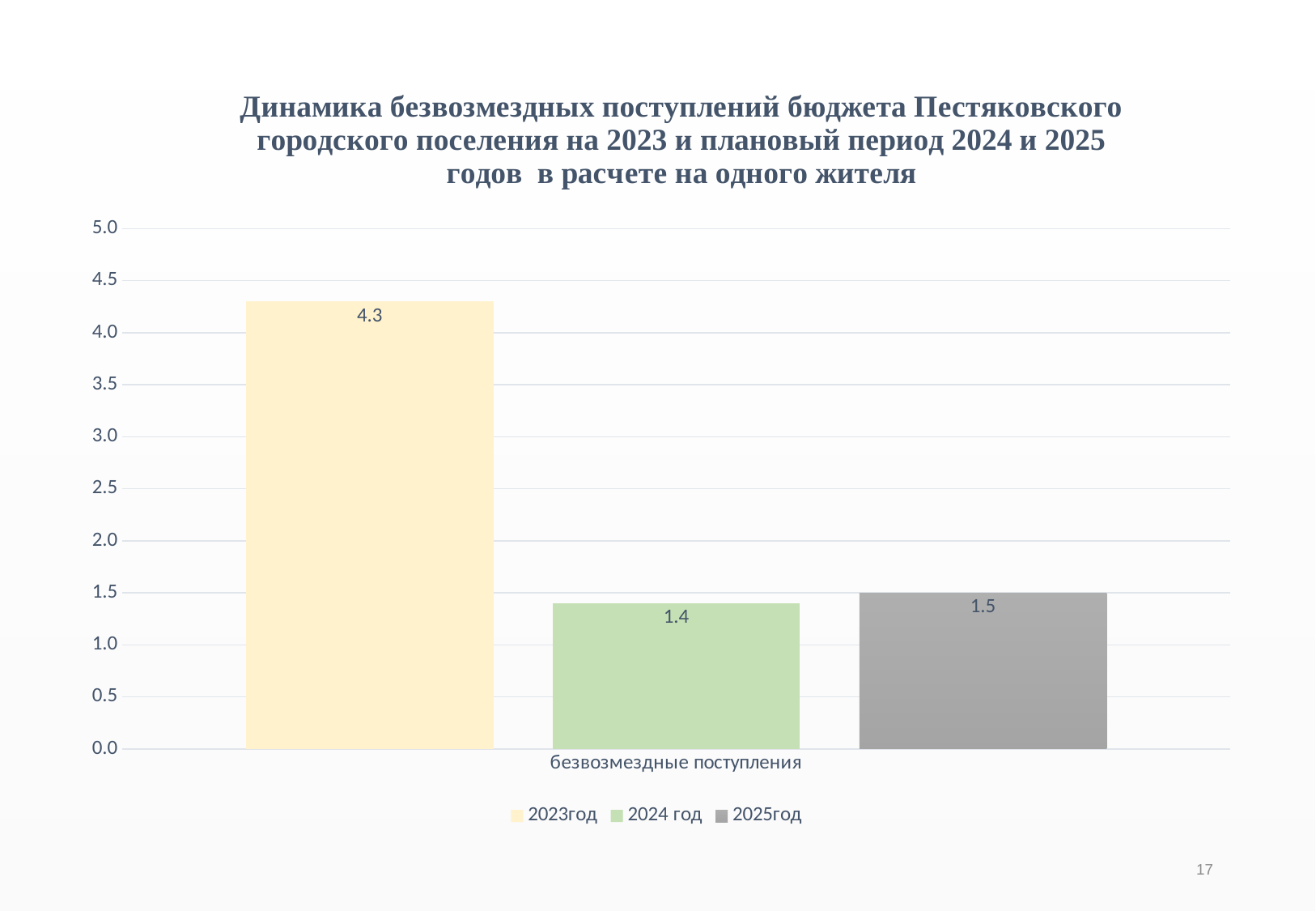
What is the value for 2025год? 1.5 Which year has the highest value? 2023год What is the value for 2024 год? 1.4 Is the value for 2023год greater or less than 4.0? greater What is the difference between the values for 2025год and 2024 год? 0.1 What is the category label shown on the x axis? безвозмездные поступления How many series does the legend list? 3 Which year has the lowest value? 2024 год What is the difference between the values for 2023год and 2024 год? 2.9 What is the value for 2023год (безвозмездные поступления)? 4.3 What kind of chart is shown on the slide? bar chart Which is larger, the value for 2023год or the value for 2025год? 2023год